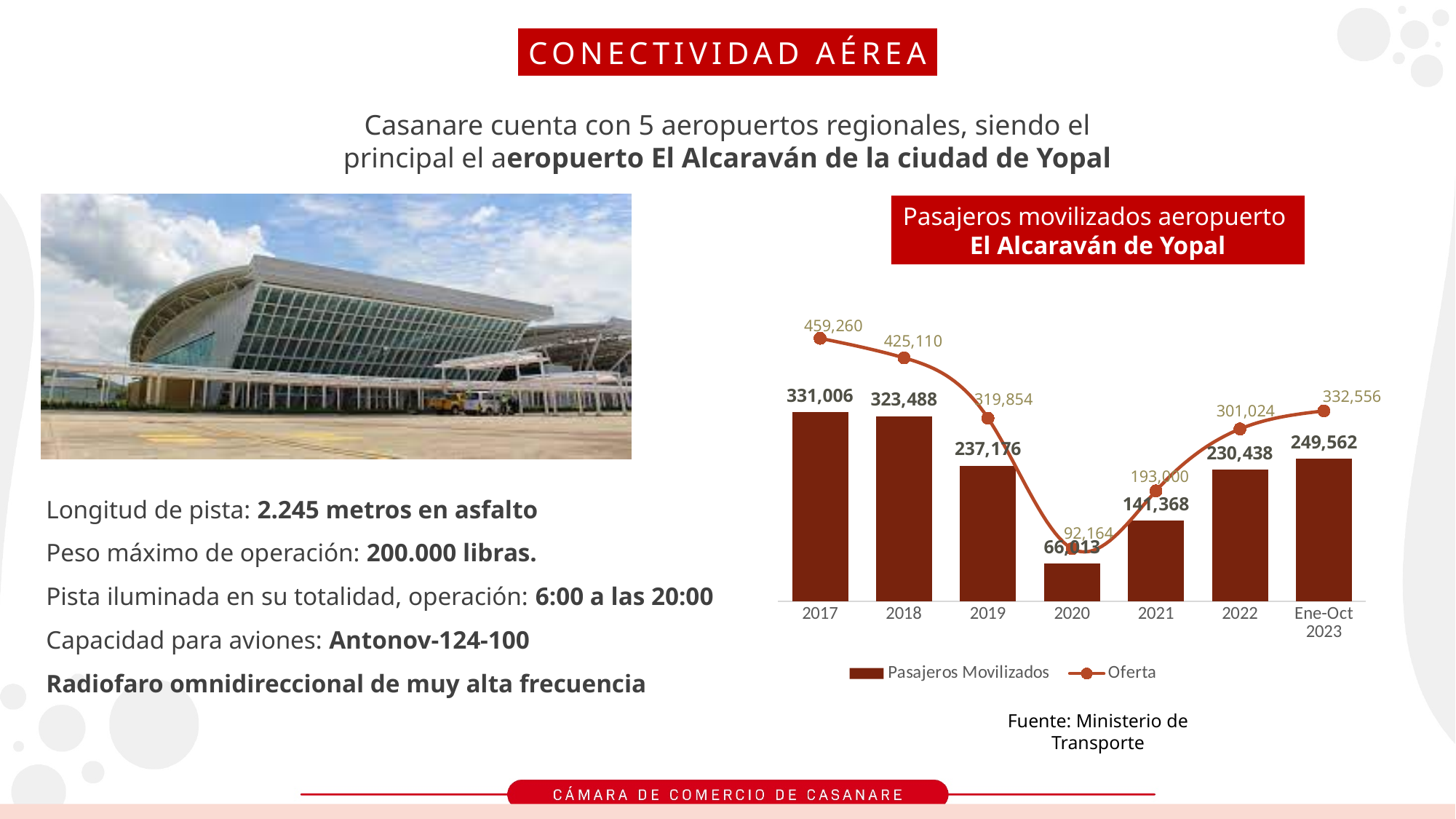
Which year had more Pasajeros Movilizados, 2021 or 2022? 2022 What is the value of Pasajeros Movilizados for Ene-Oct 2023? 249,562 Do the Pasajeros Movilizados values rise or fall from 2017 to 2020? fall What is the Oferta value for 2022? 301,024 Which year has the lowest number of Pasajeros Movilizados? 2020 Which year has the highest number of Pasajeros Movilizados? 2017 What is the difference in Pasajeros Movilizados between 2017 and 2018? 7,518 What is the Oferta value for 2017? 459,260 What is the value of Pasajeros Movilizados for 2017? 331,006 What is the difference in Oferta between 2017 and 2018? 34,150 How many series does the chart legend list? 2 How many time periods are shown on the x axis of the chart? 7